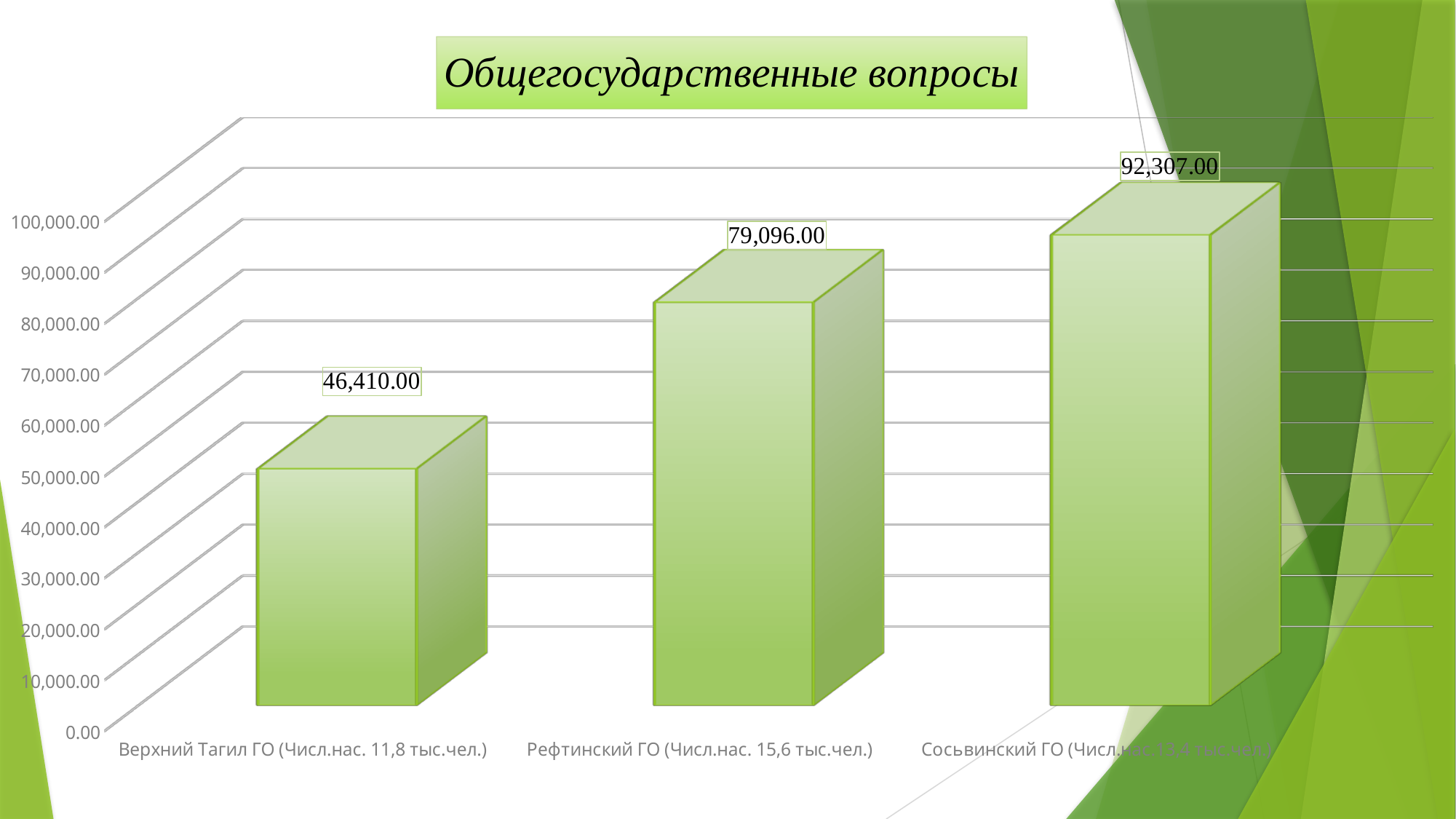
How many categories are shown in the chart? 3 Is the value for Верхний Тагил ГО greater or less than 50,000.00? less What kind of chart is shown on the slide? bar chart What is the value for Рефтинский ГО? 79,096.00 What is the value for Сосьвинский ГО? 92,307.00 What is the difference between the values for Сосьвинский ГО and Верхний Тагил ГО? 45,897.00 Which category has the highest value? Сосьвинский ГО Which category has the lowest value? Верхний Тагил ГО Which is larger, the value for Рефтинский ГО or the value for Сосьвинский ГО? Сосьвинский ГО What is the title of the chart? Общегосударственные вопросы What is the value for Верхний Тагил ГО? 46,410.00 What is the difference between the values for Рефтинский ГО and Верхний Тагил ГО? 32,686.00